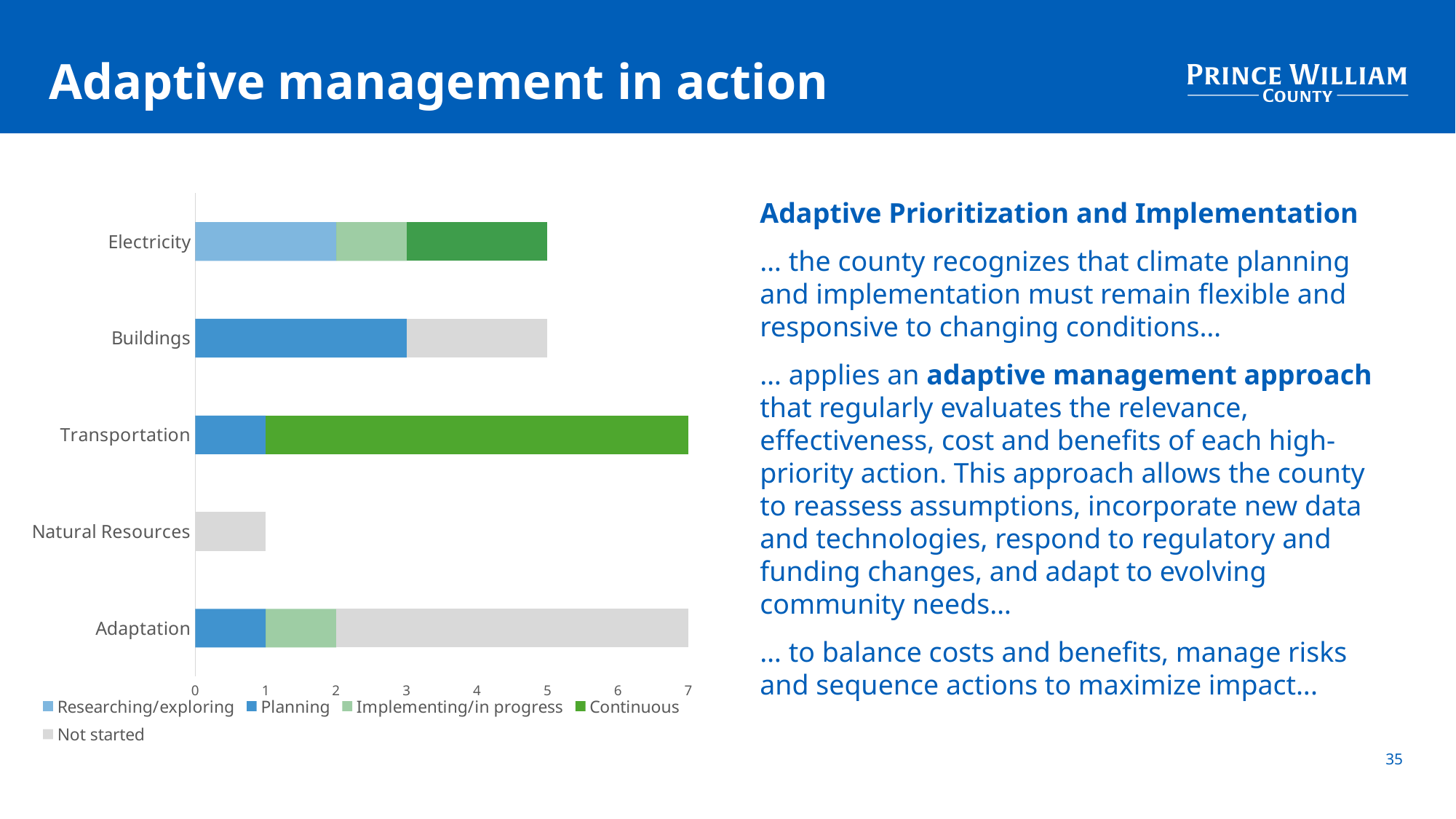
How many series does the chart's legend list? 5 Is the total value for Natural Resources greater or less than 2? less What is the total length of the Natural Resources bar? 1 What kind of chart is shown on the slide? Stacked bar chart What is the total length of the Buildings bar? 5 What is the Planning value for Buildings? 3 Which series is the only one shown for Natural Resources? Not started What is the last entry listed in the chart's legend? Not started Which has a longer total bar, Transportation or Buildings? Transportation How many categories are shown on the chart's vertical axis? 5 Which category has the shortest total bar? Natural Resources What is the total length of the Transportation bar? 7